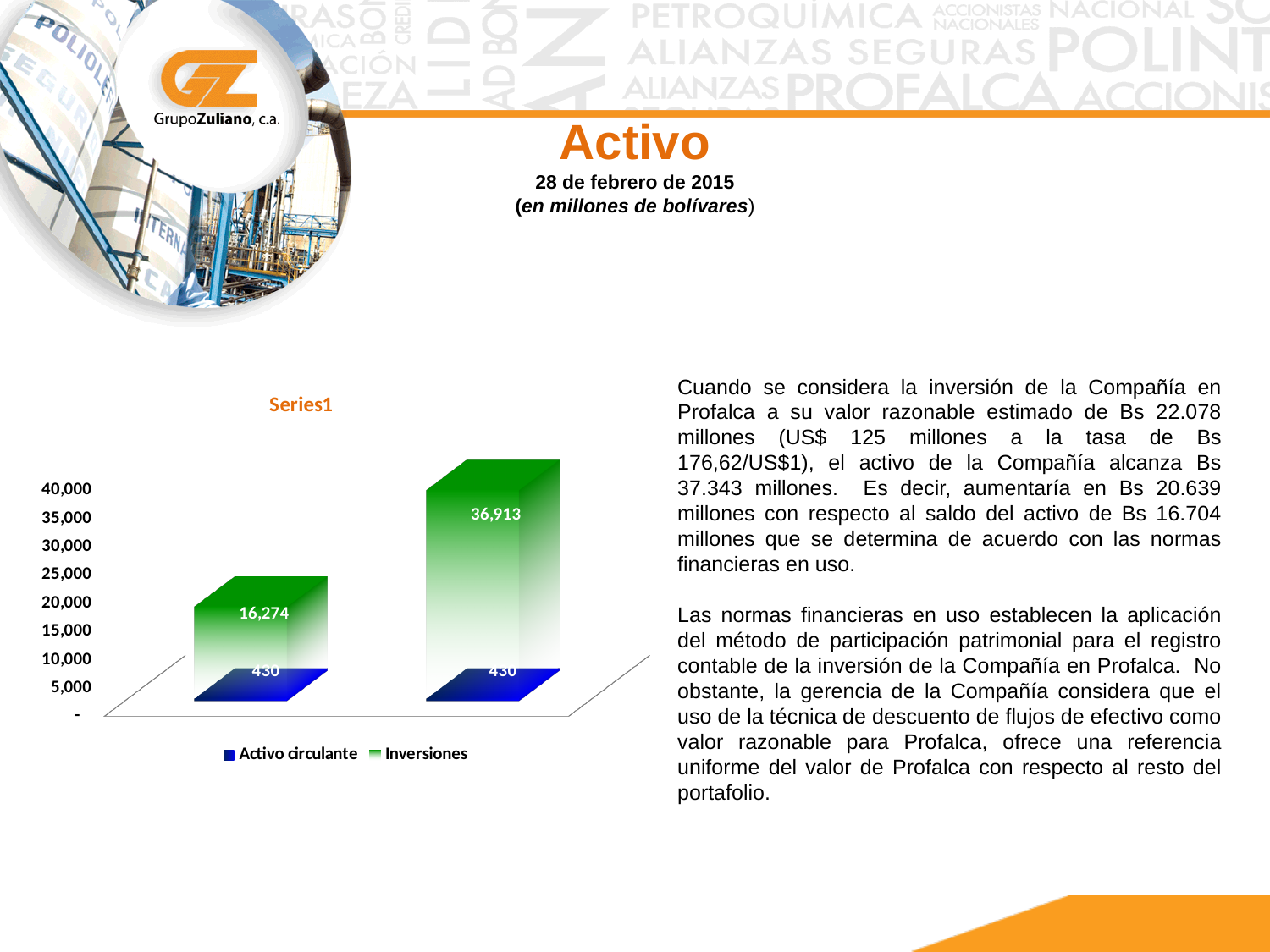
What is the title shown above the chart? Series1 What is the Activo circulante value for the right bar? 430 What is the Inversiones value for the left bar? 16,274 Which bar has the larger Inversiones value, the left or the right? Right What kind of chart is shown on the slide? Stacked bar chart What is the total of the left stacked bar? 16,704 What is the Inversiones value for the right bar? 36,913 What is the Activo circulante value for the left bar? 430 What is the total of the right stacked bar? 37,343 How many series does the chart legend list? 2 What is the difference between the Inversiones values of the right bar and the left bar? 20,639 How many bars are plotted in the chart? 2